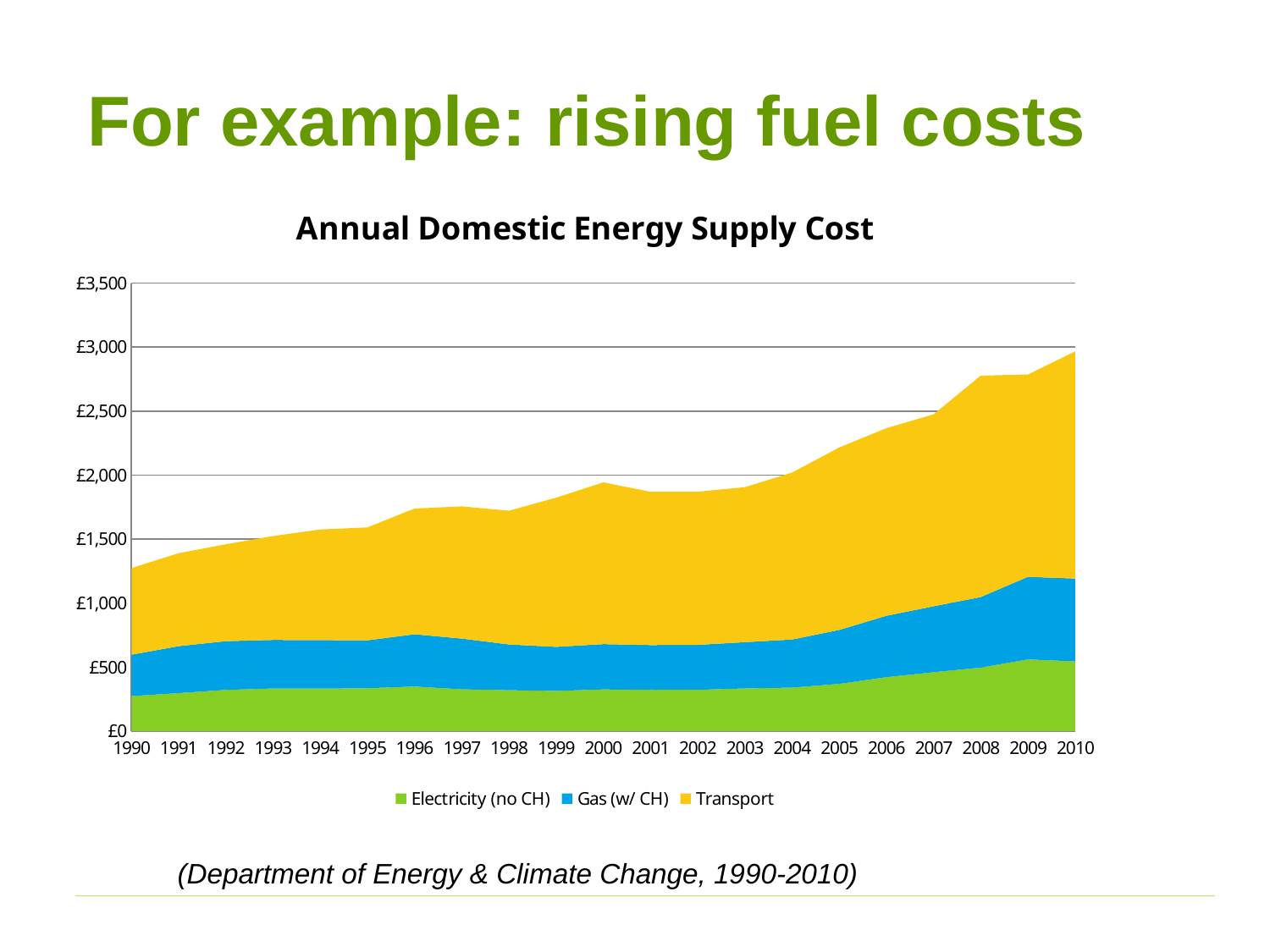
Is the total cost in 1990 greater or less than £1,500? less In which year is the total annual domestic energy supply cost lowest? 1990 How many years are plotted along the x axis? 21 Is the total cost in 2010 greater or less than £2,500? greater Which series are listed in the legend? Electricity (no CH), Gas (w/ CH), Transport Which series accounts for the largest share of the total cost in 2010? Transport Does the total annual domestic energy supply cost generally rise or fall from 1990 to 2010? Rise Is the Electricity (no CH) cost in 1990 greater or less than £500? less What is the title of the chart? Annual Domestic Energy Supply Cost How many series does the legend list? 3 What kind of chart is shown on the slide? Stacked area chart In which year is the total annual domestic energy supply cost highest? 2010